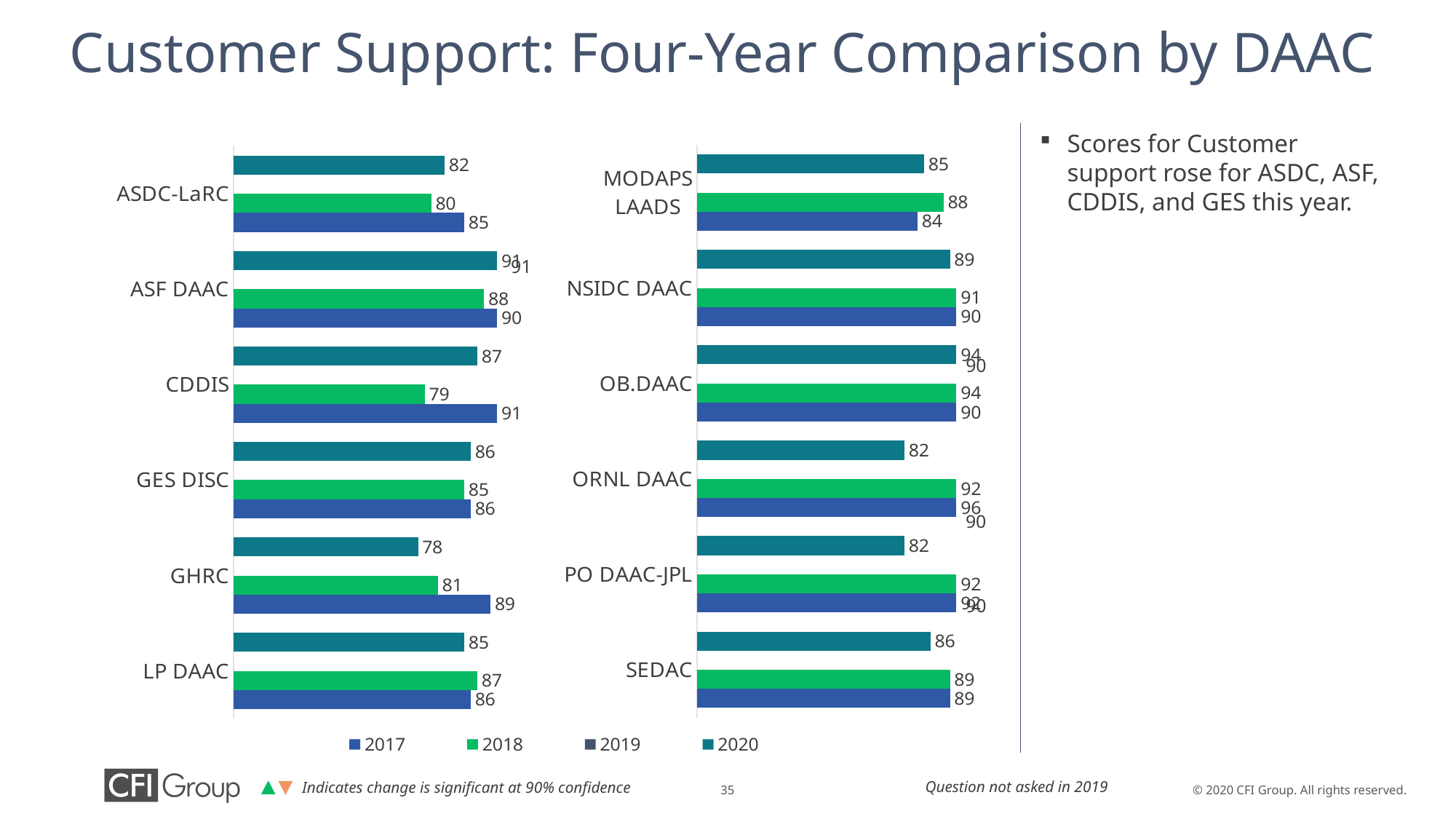
On the right chart, what is the 2017 value for MODAPS LAADS? 84 How many categories are shown on the left chart? 6 On the right chart, which category has the highest 2018 value? OB.DAAC On the left chart, what is the 2020 value for CDDIS? 87 On the left chart, which category has the lowest 2020 value? GHRC On the left chart, what is the 2018 value for GHRC? 81 On the left chart, what is the difference between the 2017 and 2018 values for CDDIS? 12 What kind of chart is used on this slide? Bar chart On the right chart, which is larger for ORNL DAAC, the 2018 value or the 2020 value? 2018 How many series does the legend list? 4 On the right chart, what is the 2020 value for SEDAC? 86 On the left chart, what is the difference between the 2017 and 2020 values for GHRC? 11